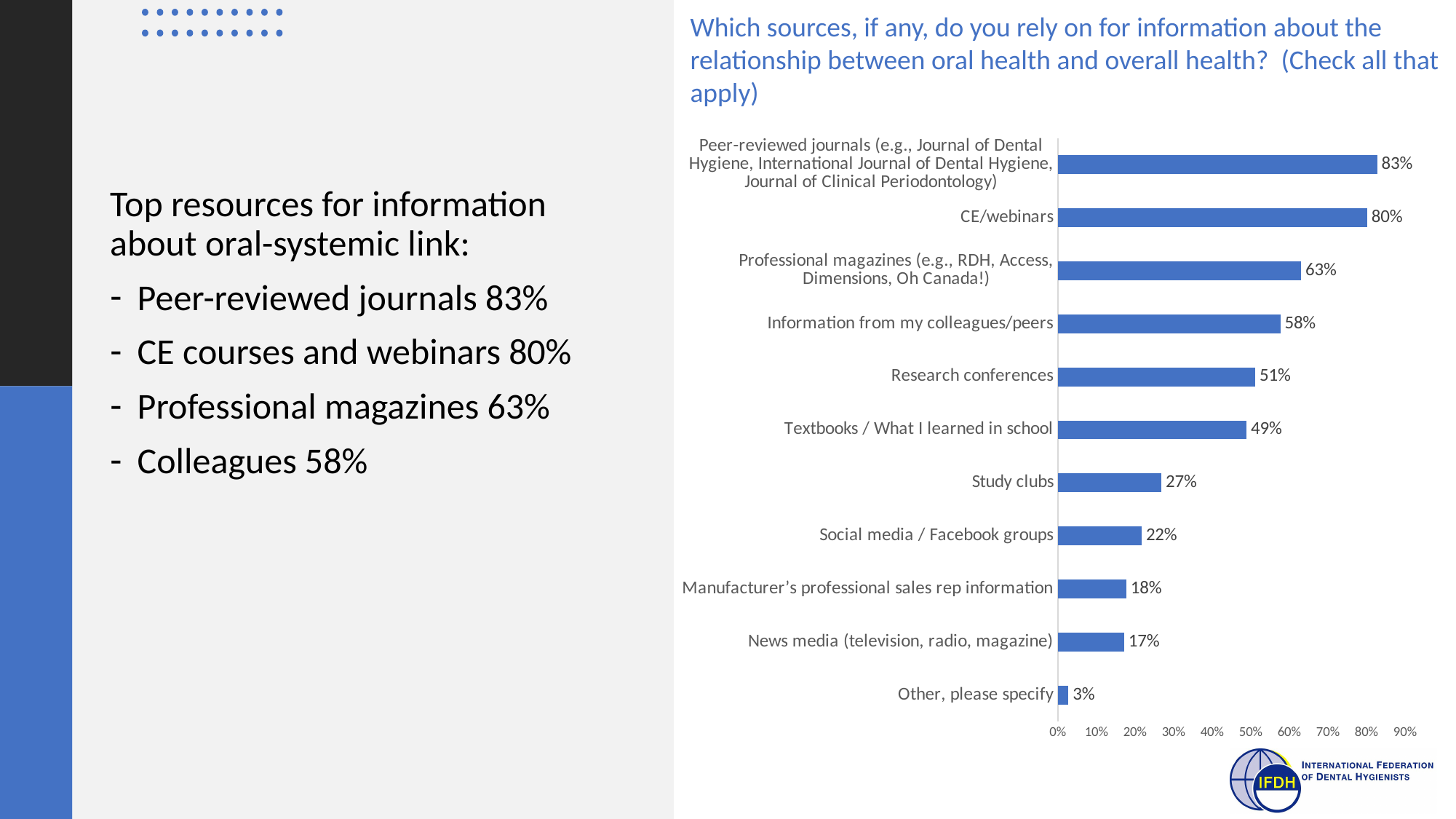
What is the difference in percentage points between Peer-reviewed journals and Information from my colleagues/peers? 25 Which source has the highest percentage in the chart? Peer-reviewed journals Which category has the lowest value in the chart? Other, please specify Which is larger: the value for Research conferences or the value for Textbooks / What I learned in school? Research conferences What is the difference between the values for Manufacturer's professional sales rep information and News media? 1 percentage point What type of chart is shown on the slide? Bar chart What percentage is shown for News media (television, radio, magazine)? 17% What is the highest tick value shown on the percentage axis of the chart? 90% How many source categories are plotted in the chart? 11 Is the value for Social media / Facebook groups greater or less than 30%? less What percentage of respondents rely on CE/webinars for information about the relationship between oral health and overall health? 80% What is the value shown for Study clubs? 27%